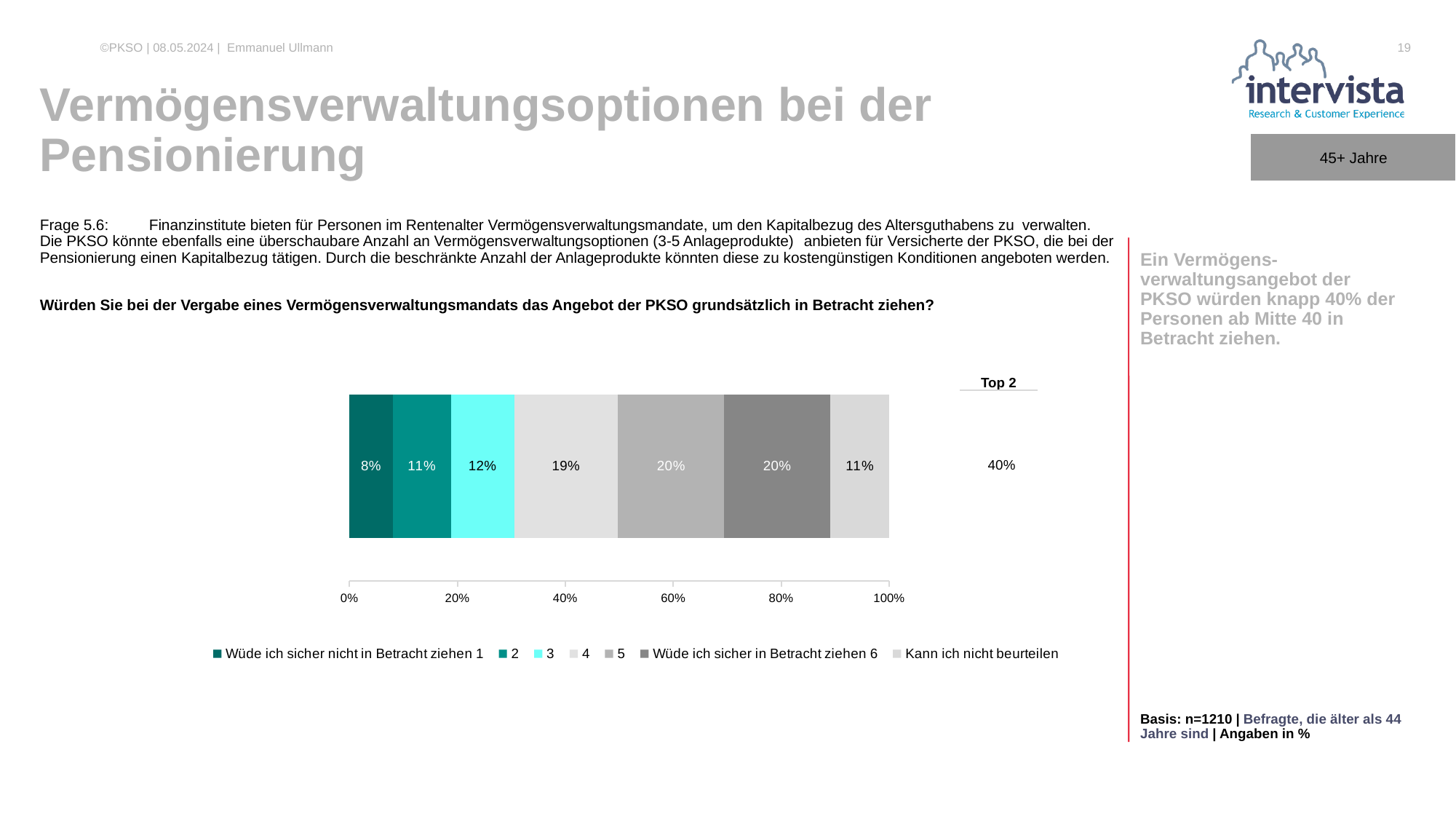
What is the total of the segments "Wüde ich sicher nicht in Betracht ziehen 1" and "2"? 19% What is the value for the segment "Kann ich nicht beurteilen"? 11% How many series does the legend list? 7 What is the highest value shown on the x axis of the chart? 100% What is the difference between the value for segment "4" and the value for segment "3"? 7% What is the Top 2 value shown to the right of the bar? 40% What percentage of respondents chose "Wüde ich sicher nicht in Betracht ziehen 1"? 8% What is the value for segment "4"? 19% Which legend category has the smallest share of the bar? Wüde ich sicher nicht in Betracht ziehen 1 What kind of chart is shown on the slide? Stacked bar chart What percentage is shown for the segment "Wüde ich sicher in Betracht ziehen 6"? 20% Which is larger, the value for segment "2" or the value for segment "5"? 5